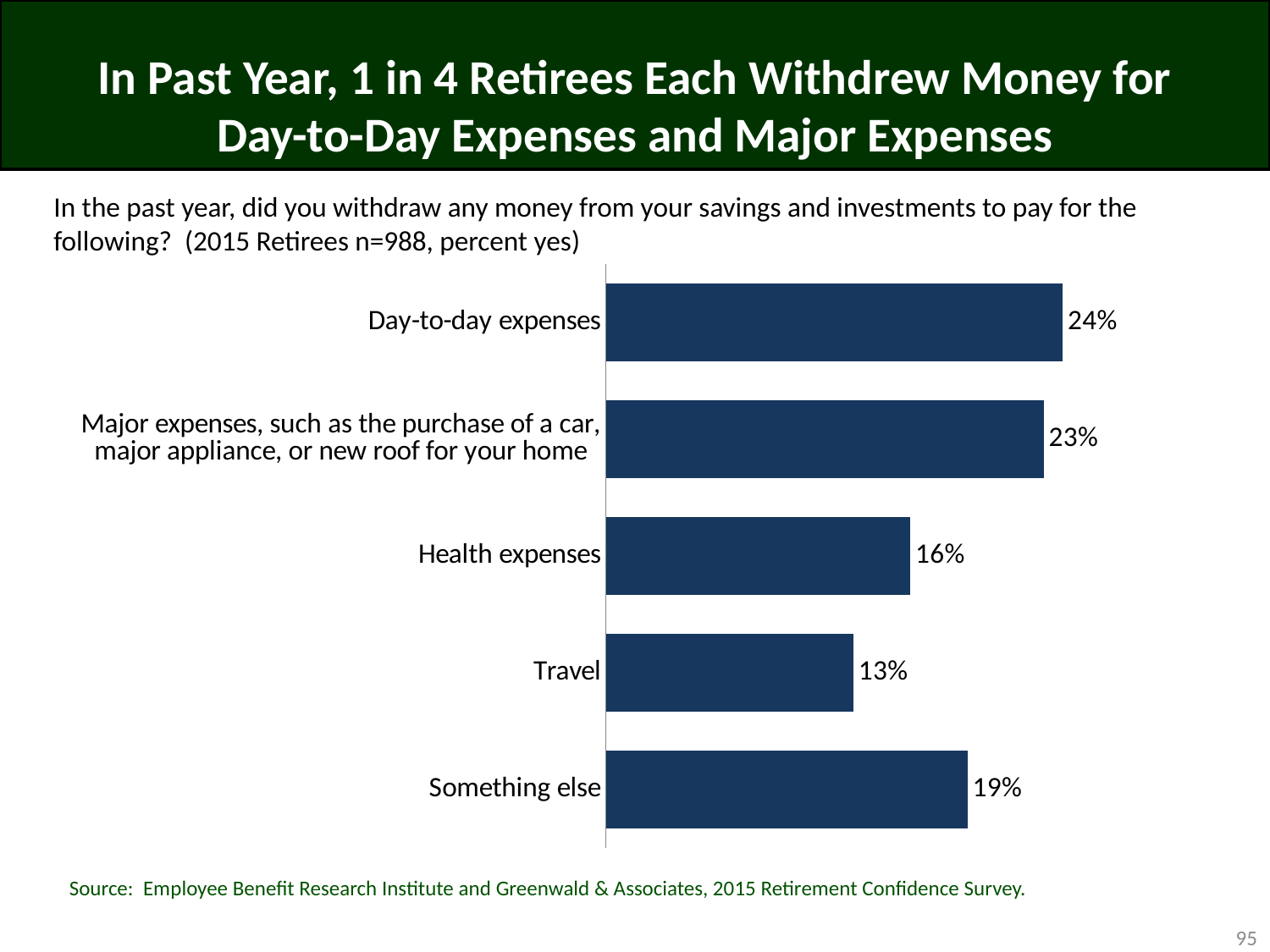
Which category has the lowest percentage of retirees withdrawing money? Travel Which category has the highest percentage of retirees withdrawing money? Day-to-day expenses What kind of chart is shown on the slide? Bar chart What percentage of retirees withdrew money for travel? 13% What percentage of retirees withdrew money for something else? 19% Which is larger, the value for health expenses or the value for something else? Something else How many categories are shown in the chart? 5 What is the difference in percentage points between health expenses and travel? 3 What percentage of retirees withdrew money for day-to-day expenses? 24% What is the difference in percentage points between day-to-day expenses and something else? 5 What percentage of retirees withdrew money for health expenses? 16% What percentage of retirees withdrew money for major expenses, such as the purchase of a car, major appliance, or new roof? 23%